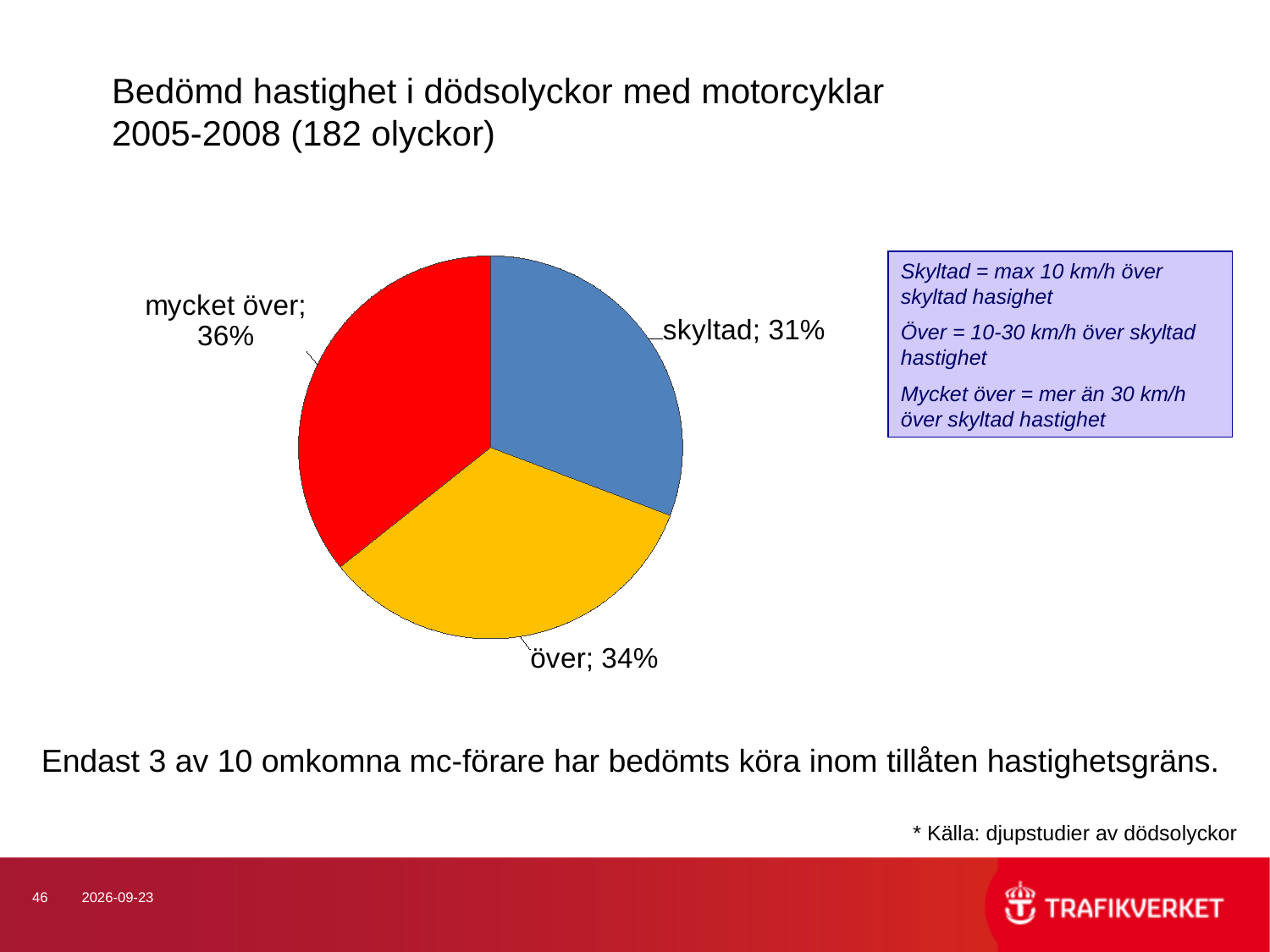
What colour is the "mycket över" slice? red What is the difference in percentage points between the "över" slice and the "skyltad" slice? 3 What type of chart is shown on the slide? pie chart How many slices does the pie chart have? 3 Which category has the smallest slice of the pie? skyltad How many accidents does the chart title say the data covers? 182 Which slice is larger, "över" or "skyltad"? över What share of the pie does the "mycket över" slice represent? 36% What share of the pie does the "skyltad" slice represent? 31% Which category has the largest slice of the pie? mycket över What share of the pie does the "över" slice represent? 34% What is the difference in percentage points between the "mycket över" slice and the "skyltad" slice? 5